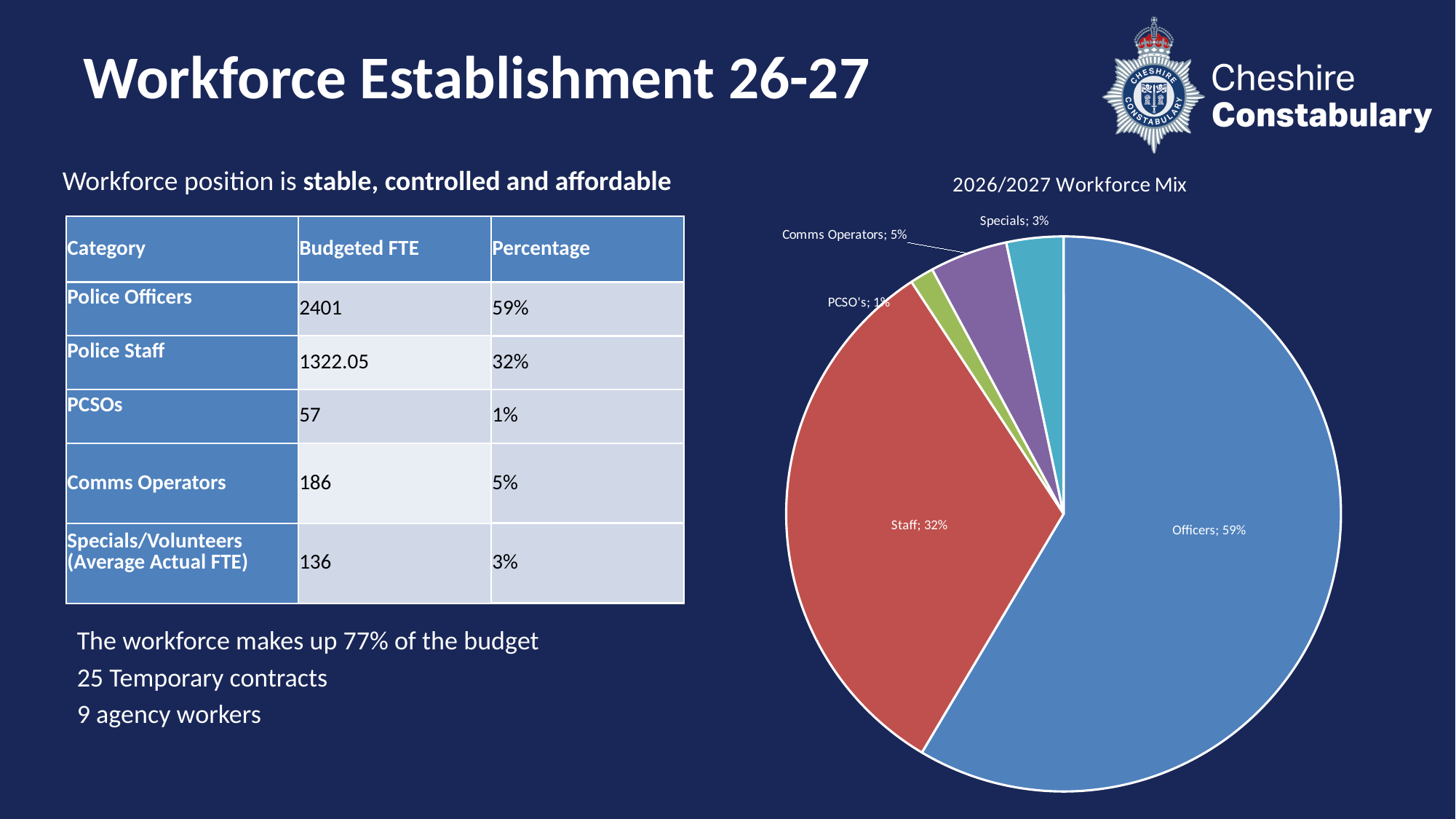
Which slice of the pie is the largest? Officers What is the difference in percentage points between the Officers slice and the Staff slice? 27 What share of the pie does Officers represent? 59% Which is larger, the Comms Operators slice or the Specials slice? Comms Operators What share of the pie does PCSO's represent? 1% What kind of chart is shown on the slide? pie chart What is the title of the chart? 2026/2027 Workforce Mix What share of the pie does Specials represent? 3% Which slice of the pie is the smallest? PCSO's How many slices does the pie chart have? 5